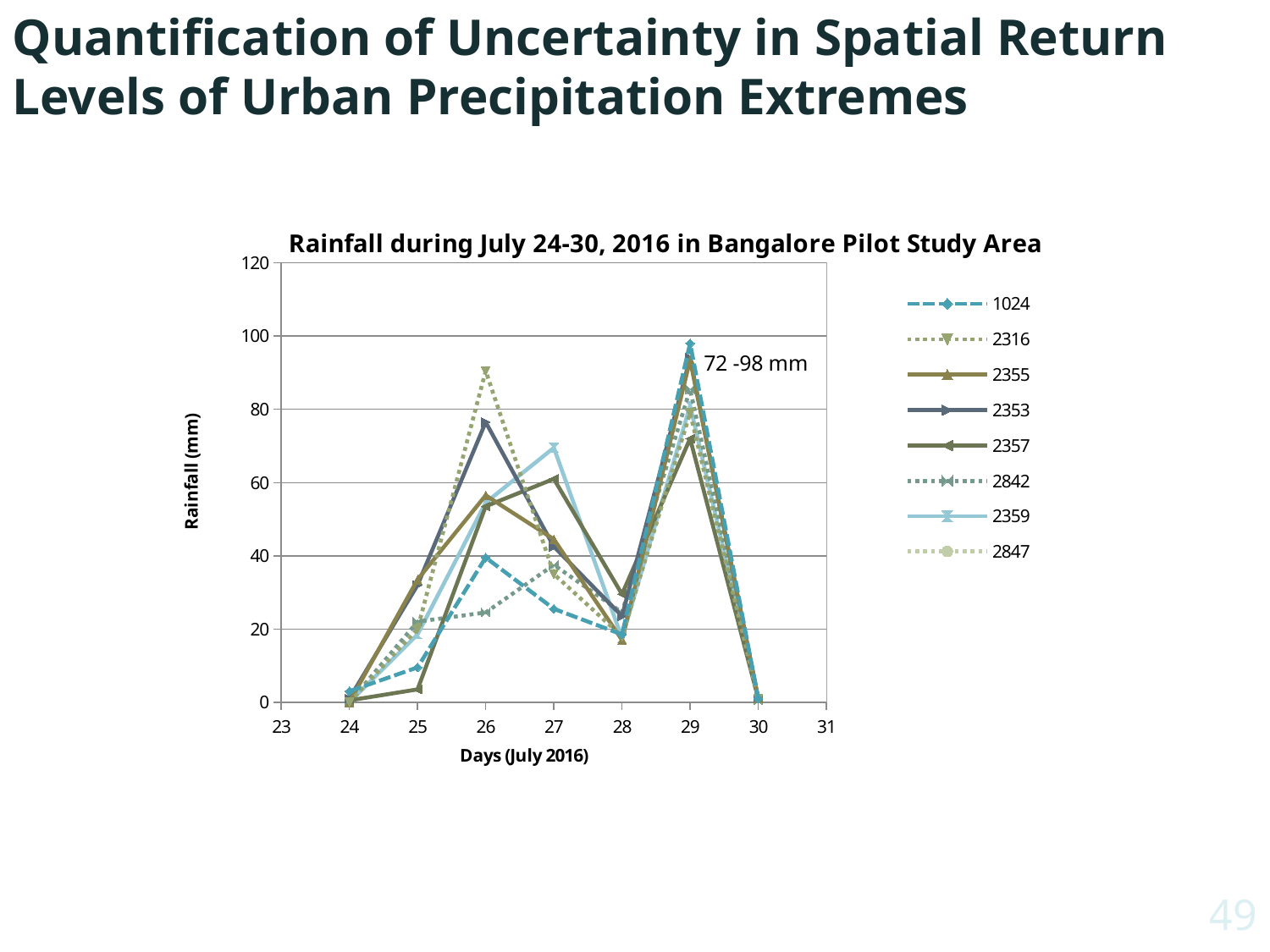
What is the label of the y axis? Rainfall (mm) What kind of chart is shown on the slide? line chart Do the rainfall values rise or fall from July 29 to July 30? fall What range of rainfall is annotated on the chart for the peak on July 29? 72 -98 mm Is the rainfall for series 2316 on July 26 greater or less than 80? greater Which series has the highest rainfall on July 26? 2316 On which day do the series reach their highest rainfall values? 29 What is the title of the chart? Rainfall during July 24-30, 2016 in Bangalore Pilot Study Area How many series does the legend list? 8 Is the rainfall for series 2359 on July 27 greater or less than 60? greater Is the rainfall for series 2357 on July 29 greater or less than 60? greater How many days have rainfall values plotted on the chart? 7